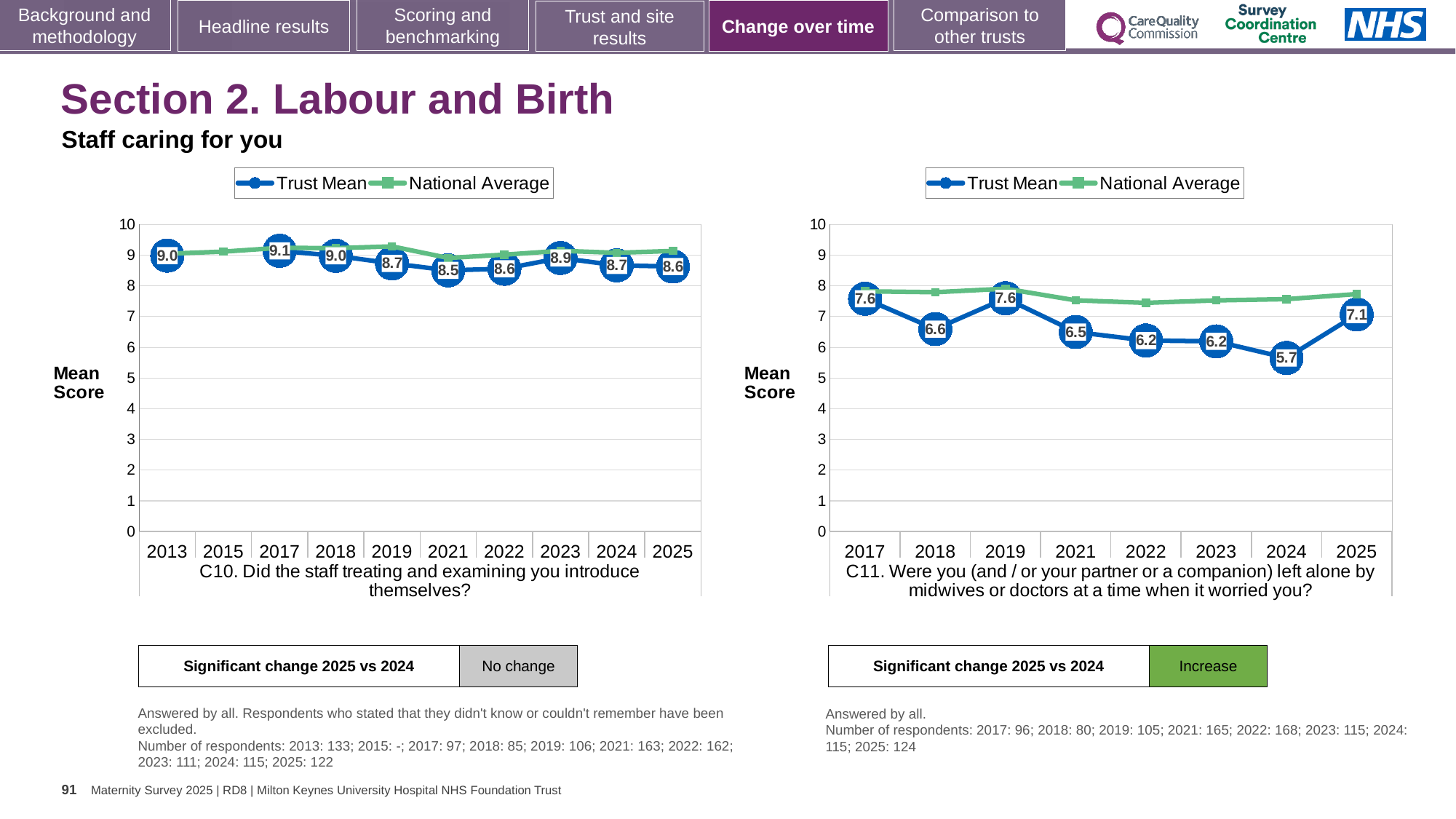
How many years are shown on the x axis of the C11 chart on the right? 8 In the C10 chart on the left, what is the Trust Mean score for 2017? 9.1 In the C11 chart on the right, what is the difference between the Trust Mean scores for 2025 and 2024? 1.4 In the C10 chart on the left, which year has the highest Trust Mean score? 2017 In the C10 chart on the left, which year has the lowest Trust Mean score? 2021 How many series does the legend of the C10 chart on the left list? 2 In the C11 chart on the right, is the Trust Mean score for 2018 or 2019 higher? 2019 In the C11 chart on the right, does the Trust Mean rise or fall from 2019 to 2024? Fall In the C11 chart on the right, what is the Trust Mean score for 2024? 5.7 In the C11 chart on the right, is the National Average for 2024 greater or less than 7? greater What kind of chart is the C10 chart on the left? Line chart In the C11 chart on the right, which year has the lowest Trust Mean score? 2024